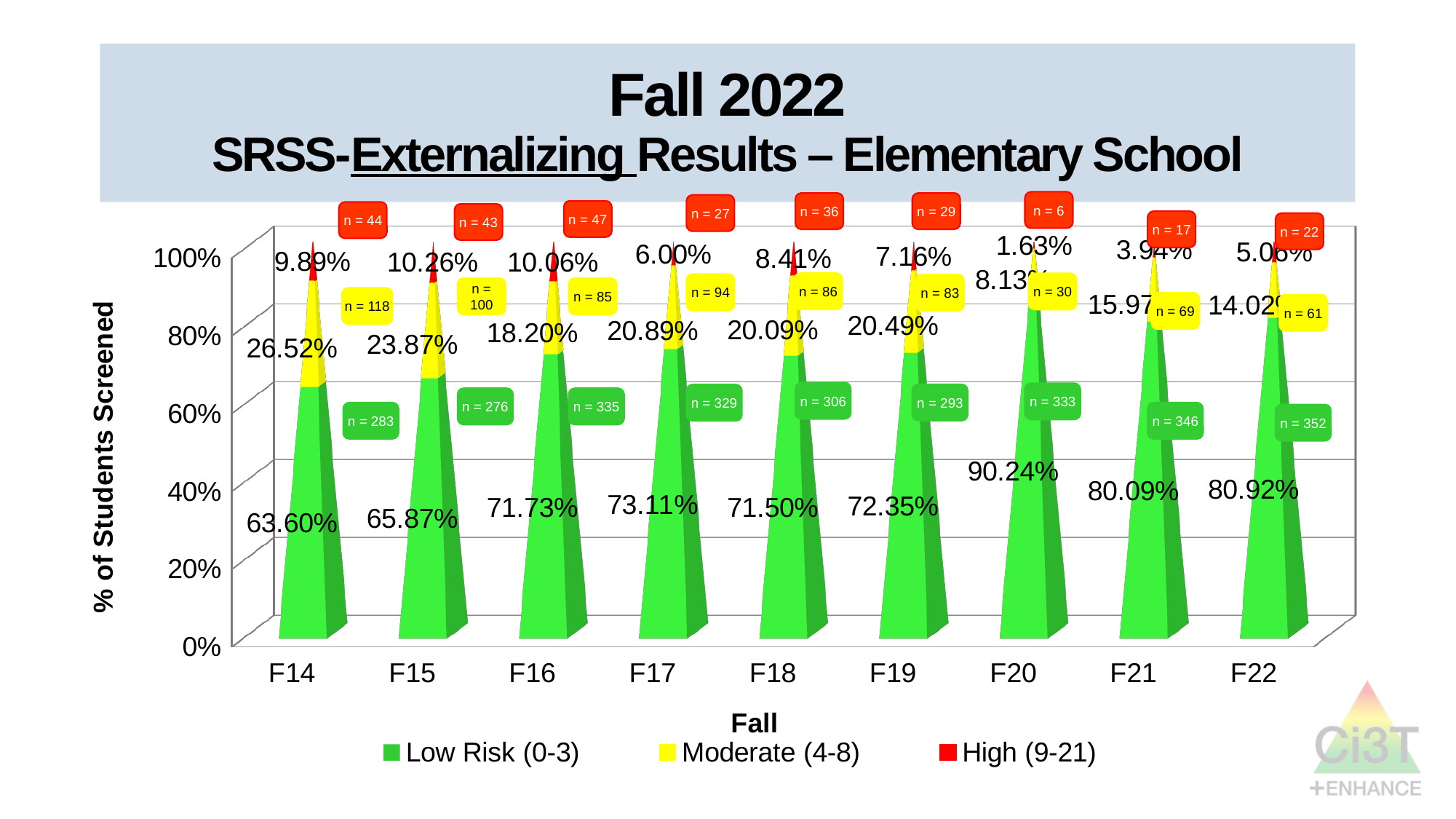
Which fall has the lowest High (9-21) percentage? F20 Which fall has the highest Low Risk (0-3) percentage? F20 What is the Low Risk (0-3) percentage for F14? 63.60% How many fall semesters are shown on the x axis? 9 What is the difference between the Low Risk (0-3) percentages for F15 and F14? 2.27 percentage points Does the Low Risk (0-3) percentage rise or fall from F14 to F17? Rise What kind of chart is shown on the slide? Stacked bar chart What is the Moderate (4-8) percentage for F16? 18.20% What is the High (9-21) percentage for F17? 6.00% How many series does the legend list? 3 What is the n value shown for the Low Risk (0-3) group in F22? n = 352 Which is larger, the High (9-21) percentage for F15 or for F16? F15